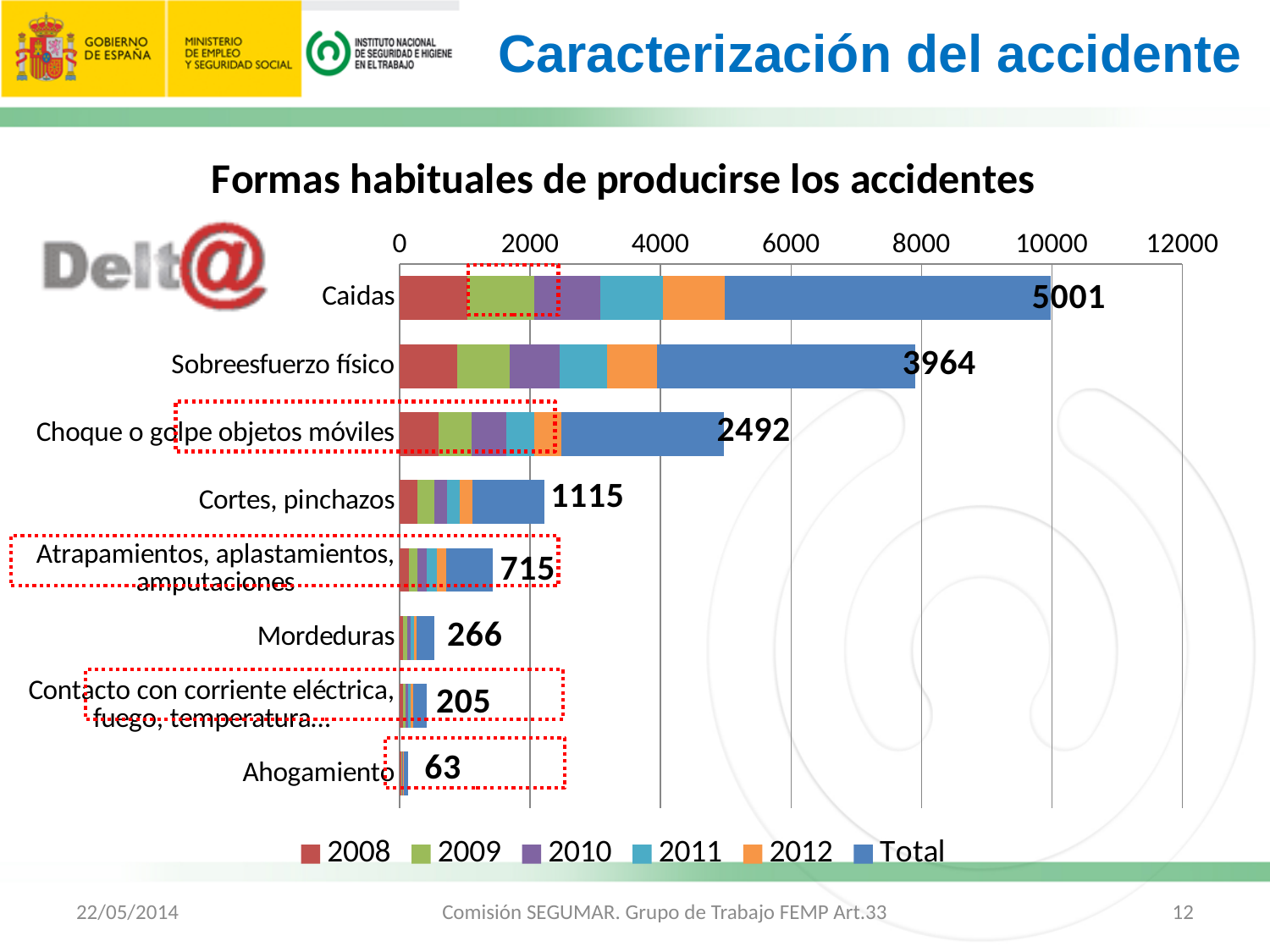
Which category has the lowest Total value? Ahogamiento What is the difference between the Total values for Choque o golpe objetos móviles and Cortes, pinchazos? 1377 What is the value of the Total series for Mordeduras? 266 What is the difference between the Total values for Caidas and Sobreesfuerzo físico? 1037 What is the value of the Total series for Ahogamiento? 63 Which has a larger Total value, Mordeduras or Contacto con corriente eléctrica, fuego, temperatura...? Mordeduras What is the value of the Total series for Sobreesfuerzo físico? 3964 What kind of chart is shown on the slide? Stacked bar chart What is the value of the Total series for Caidas? 5001 Which category has the highest Total value? Caidas How many series does the legend list? 6 How many categories are shown on the chart? 8